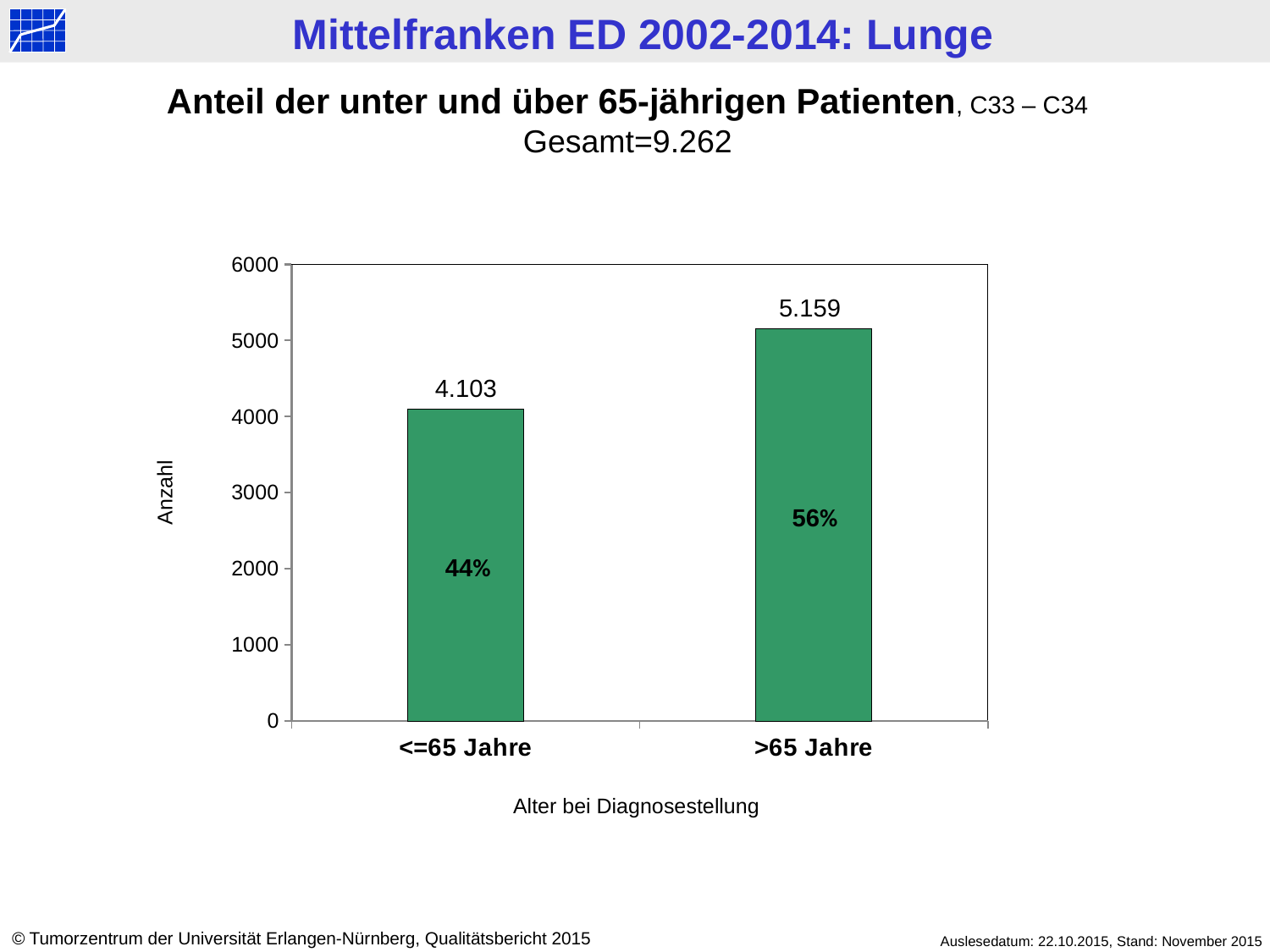
What is the label of the x axis? Alter bei Diagnosestellung Which is larger, the value for <=65 Jahre or for >65 Jahre? >65 Jahre What is the value for the <=65 Jahre category? 4.103 What percentage is shown on the >65 Jahre bar? 56% Which category has the lowest value? <=65 Jahre Is the value for <=65 Jahre greater or less than 5000? less What is the value for the >65 Jahre category? 5.159 What kind of chart is shown on the slide? bar chart How many categories are shown on the x axis? 2 Which category has the highest value? >65 Jahre What percentage is shown on the <=65 Jahre bar? 44% What is the difference between the values for >65 Jahre and <=65 Jahre? 1.056